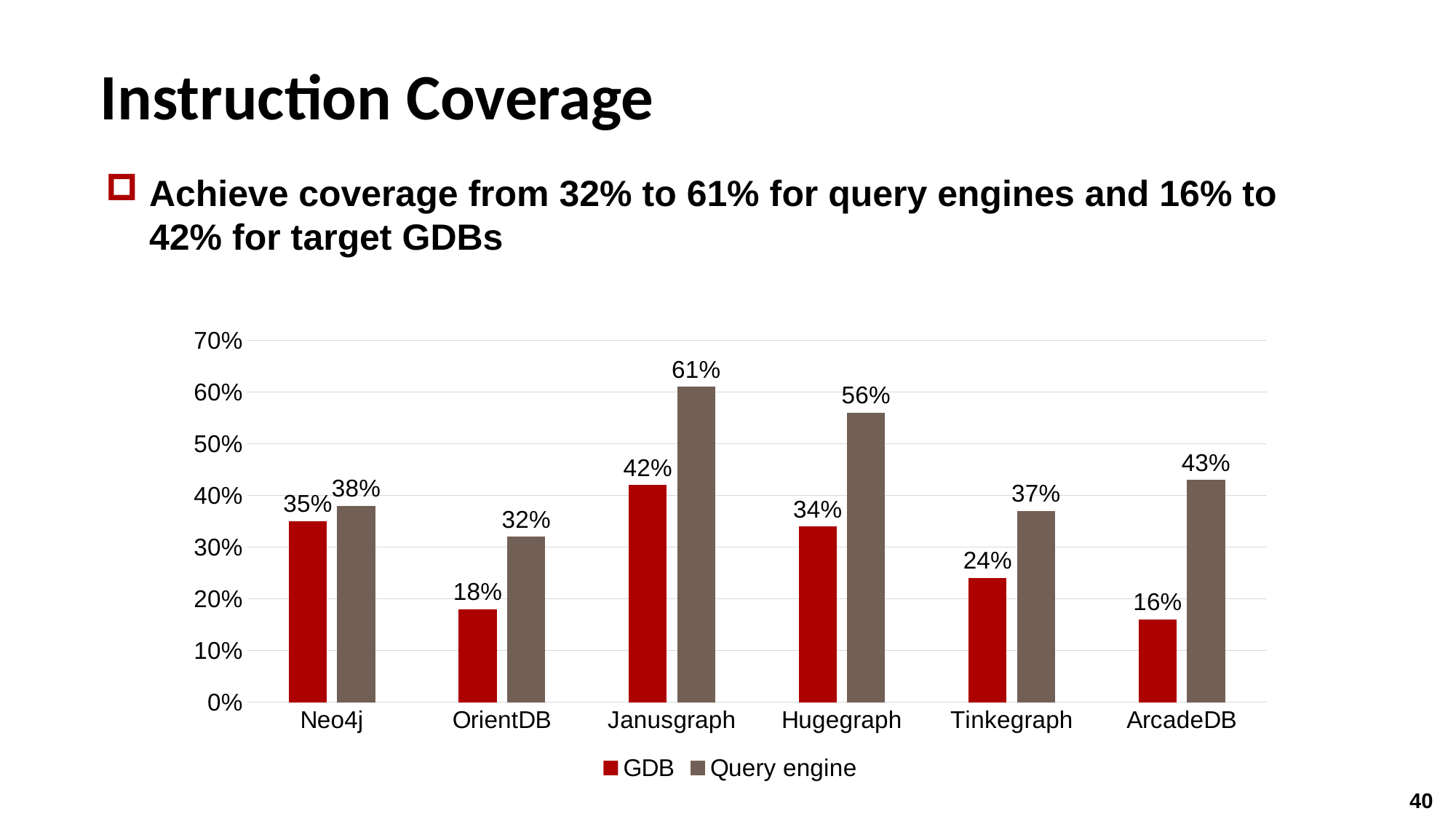
Which is larger for Tinkegraph, the GDB value or the Query engine value? Query engine What is the difference between the Query engine and GDB values for Hugegraph? 22% What colour are the GDB bars? Red How many categories are shown on the x axis? 6 What is the Query engine coverage value for ArcadeDB? 43% Which category has the highest Query engine value? Janusgraph How many series does the legend list? 2 What kind of chart is shown on the slide? Bar chart What is the difference between the Query engine values for Janusgraph and OrientDB? 29% What is the GDB coverage value for Janusgraph? 42% Which category has the lowest GDB value? ArcadeDB What is the GDB coverage value for OrientDB? 18%